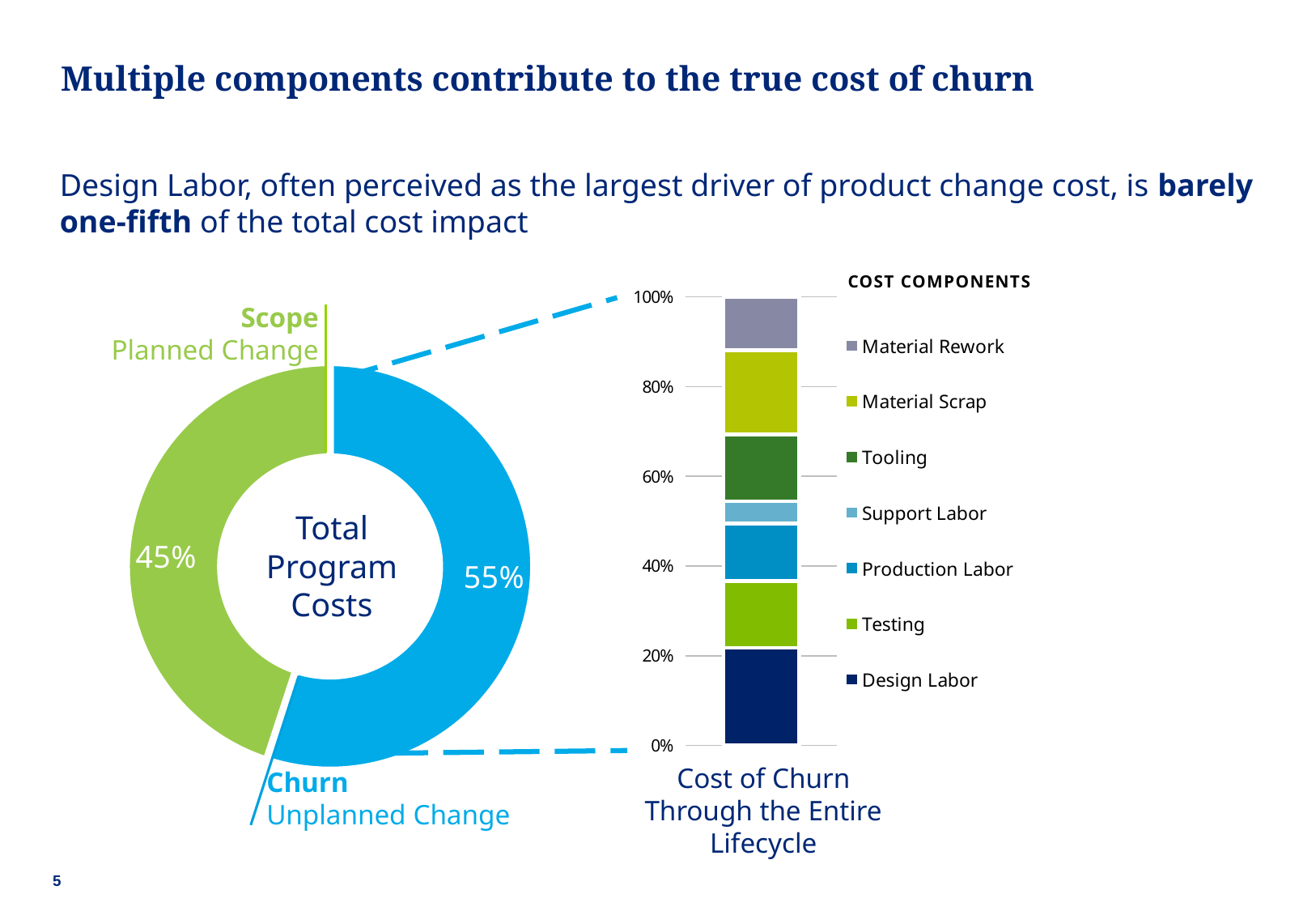
In the Cost of Churn Through the Entire Lifecycle chart, which segment is larger: Design Labor or Material Rework? Design Labor What kind of chart is the Cost of Churn Through the Entire Lifecycle chart on the right? Stacked bar chart In the donut chart, what share of Total Program Costs is Scope (Planned Change)? 45% In the donut chart, what is the difference in percentage points between the Churn share and the Scope share? 10 percentage points In the Cost of Churn Through the Entire Lifecycle chart, which cost component is at the top of the stacked bar? Material Rework How many slices does the Total Program Costs donut chart have? 2 In the donut chart, which is larger: Scope or Churn? Churn What is the title of the legend next to the Cost of Churn Through the Entire Lifecycle chart? COST COMPONENTS In the Cost of Churn Through the Entire Lifecycle chart, which cost component is the smallest segment? Support Labor How many cost components does the legend of the Cost of Churn Through the Entire Lifecycle chart list? 7 In the donut chart, what share of Total Program Costs is Churn (Unplanned Change)? 55% What kind of chart is the Total Program Costs chart on the left? Donut (pie) chart